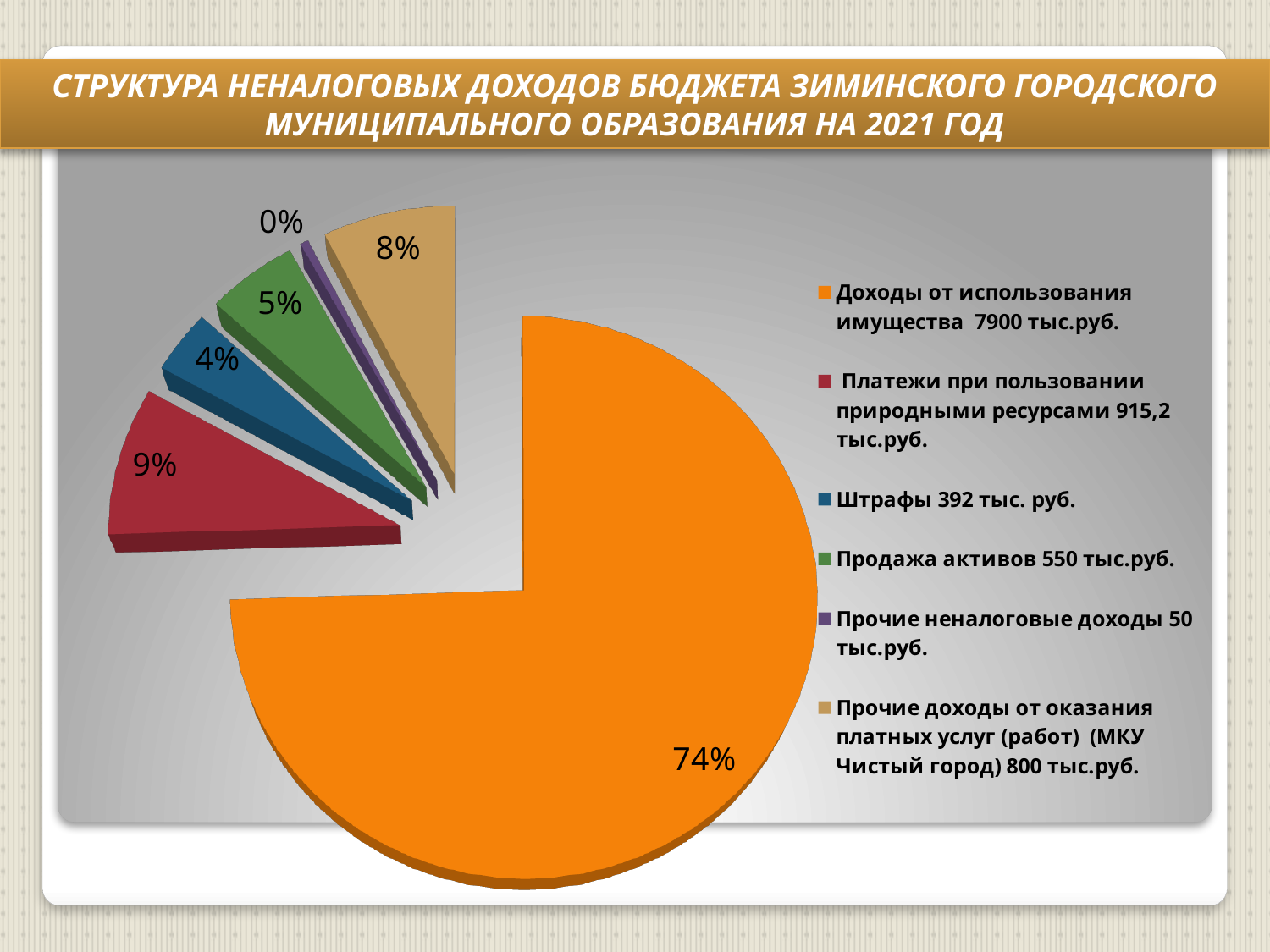
What share of the pie does "Штрафы" take? 4% What kind of chart is shown on the slide? Pie chart What is the difference in percentage points between the "Платежи при пользовании природными ресурсами" slice and the "Продажа активов" slice? 4% Which category has the largest slice of the pie? Доходы от использования имущества What amount is listed in the legend for "Штрафы"? 392 тыс. руб. What share of the pie does "Доходы от использования имущества" take? 74% Which slice is larger: "Продажа активов" or "Штрафы"? Продажа активов What share of the pie does "Платежи при пользовании природными ресурсами" take? 9% Which category has the smallest slice of the pie? Прочие неналоговые доходы How many slices does the pie chart have? 6